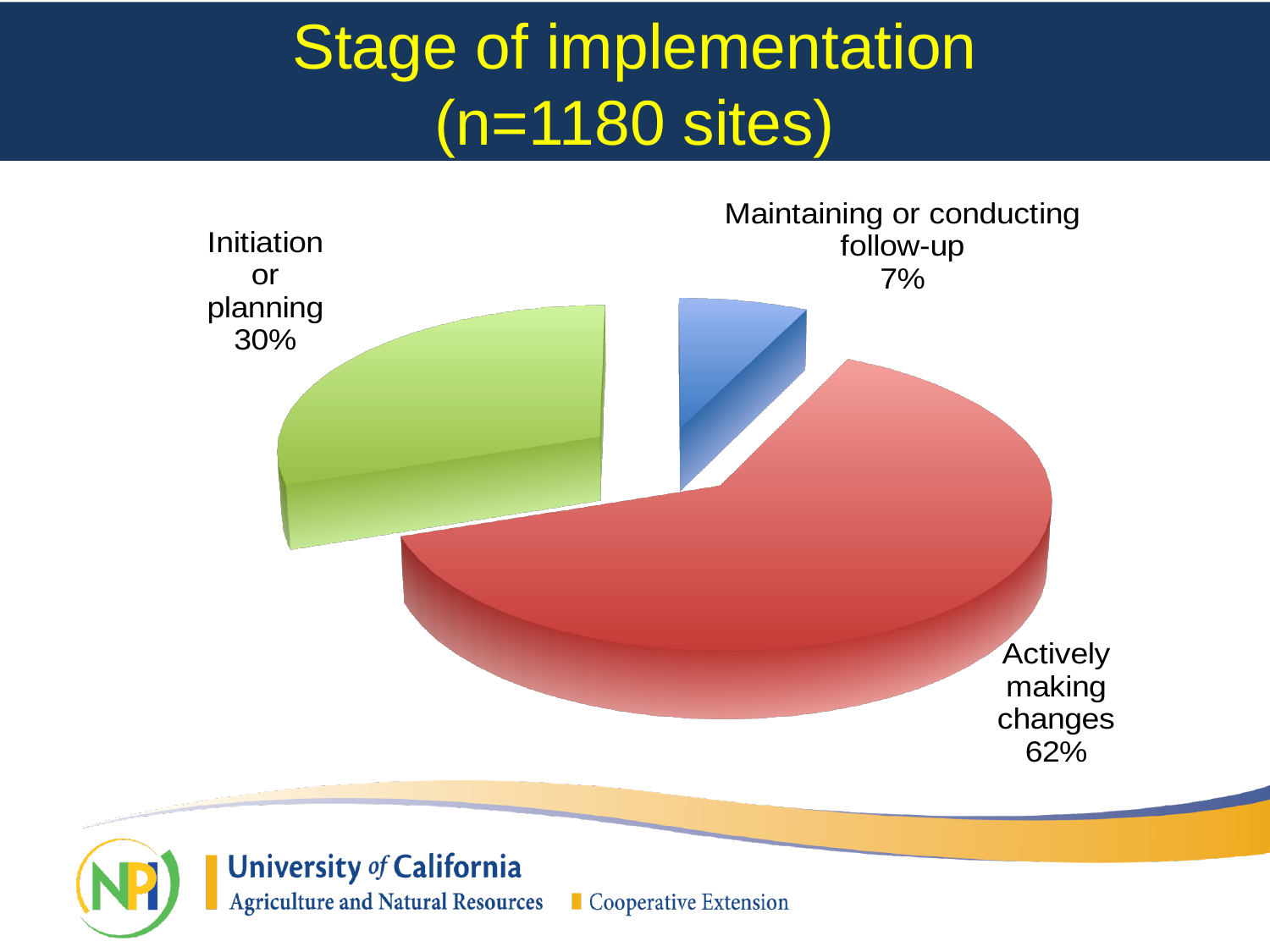
What is the difference in percentage points between the 'Actively making changes' slice and the 'Initiation or planning' slice? 32 What share of sites are maintaining or conducting follow-up? 7% Which is larger: the share for 'Initiation or planning' or the share for 'Maintaining or conducting follow-up'? Initiation or planning What is the title of the chart on the slide? Stage of implementation (n=1180 sites) Which stage of implementation has the smallest share of sites? Maintaining or conducting follow-up What share of sites are actively making changes? 62% How many slices does the pie chart have? 3 What is the difference in percentage points between the 'Initiation or planning' slice and the 'Maintaining or conducting follow-up' slice? 23 What share of sites are in the initiation or planning stage? 30% What kind of chart is shown on the slide? Pie chart What colour is the 'Actively making changes' slice? Red Which stage of implementation has the largest share of sites? Actively making changes